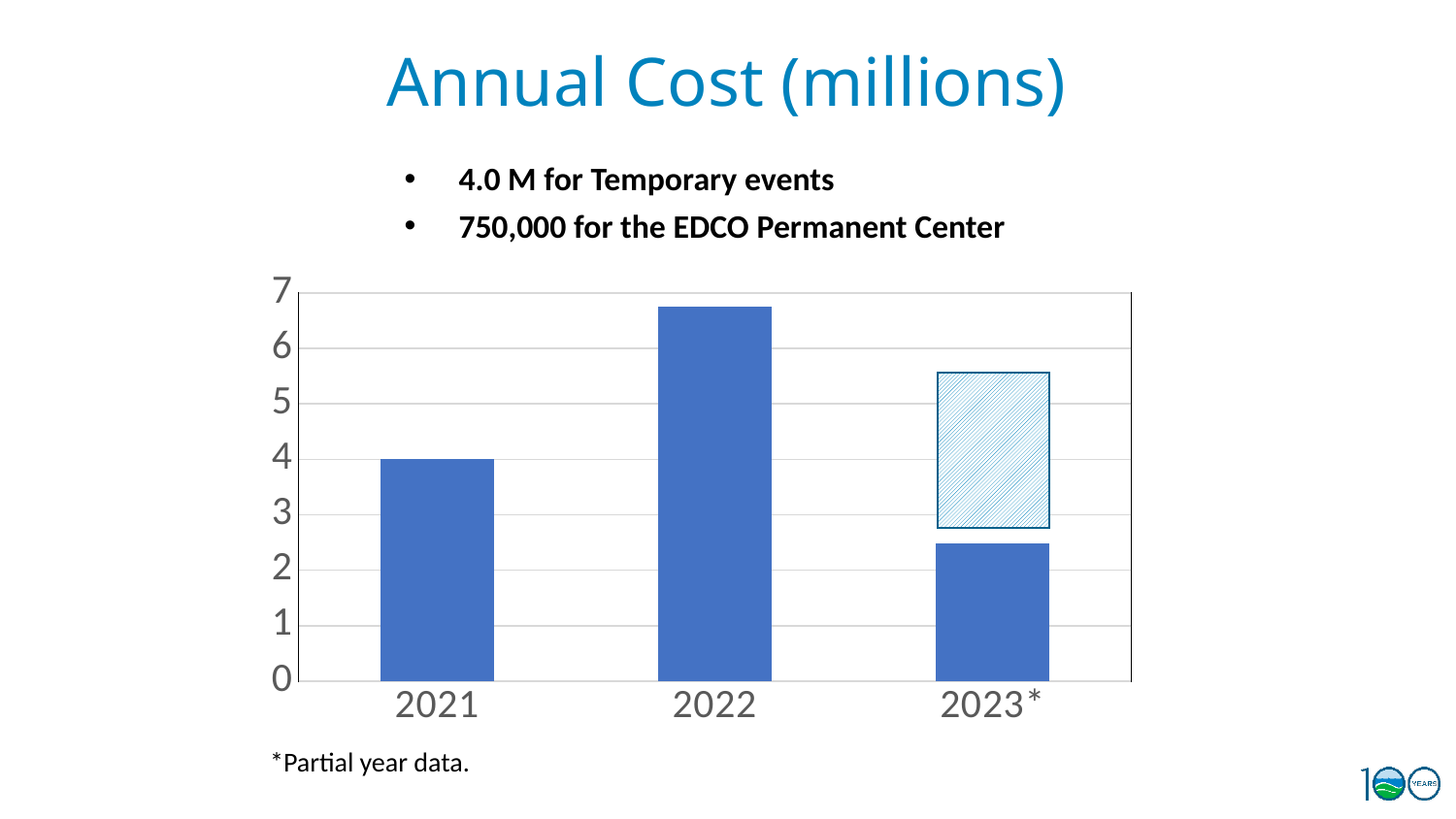
Is the solid bar for 2023* greater or less than 3? less What is the title of the chart? Annual Cost (millions) Which year has the highest bar in the chart? 2022 What is the highest value shown on the y axis? 7 Is the value for 2021 greater or less than 5? less How many years are shown on the x axis of the chart? 3 Which year has the shortest solid bar in the chart? 2023* Which is larger, the bar for 2021 or the bar for 2022? 2022 What kind of chart is shown on the slide? bar chart Is the value for 2022 greater or less than 6? greater Which year's bar has a hatched section on top of it? 2023*